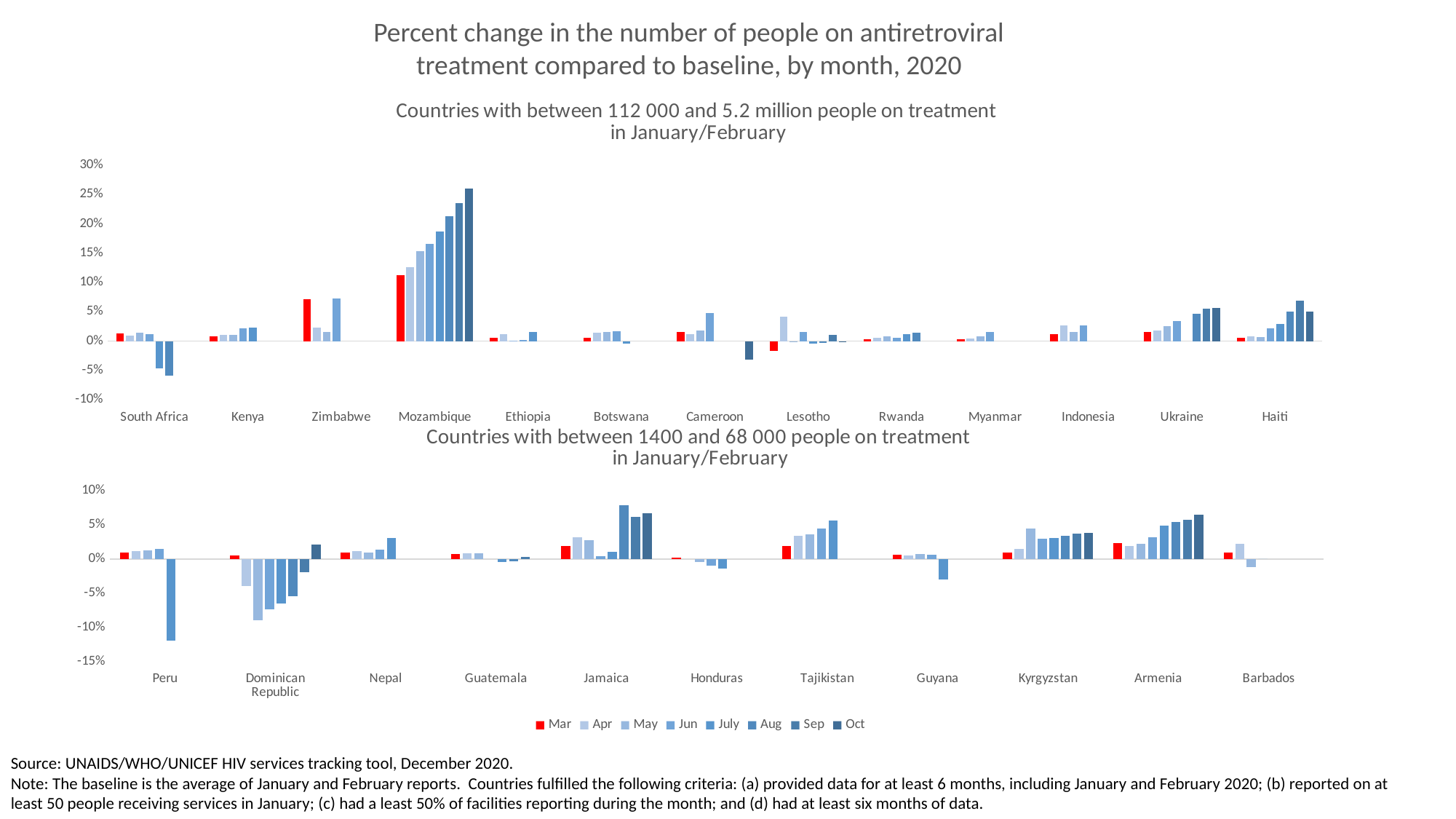
What kind of chart is used on this slide? Bar chart In the bottom chart, is the lowest value for Peru greater or less than -10%? less In the top chart, is the value for Mozambique in Oct greater or less than 20%? greater In the top chart, which country has the highest percent change? Mozambique In the top chart, do the values for Mozambique rise or fall from Mar to Oct? rise In the bottom chart (countries with between 1400 and 68 000 people on treatment), how many countries are shown? 11 How many series does the legend list? 8 In the bottom chart, which country has the lowest percent change? Peru In the top chart, which is larger, the Mar value for Zimbabwe or the Mar value for Kenya? Zimbabwe In the top chart (countries with between 112 000 and 5.2 million people on treatment), how many countries are shown? 13 What colour represents the Mar series in the legend? Red In the bottom chart, is the value for Jamaica in Aug greater or less than 5%? greater